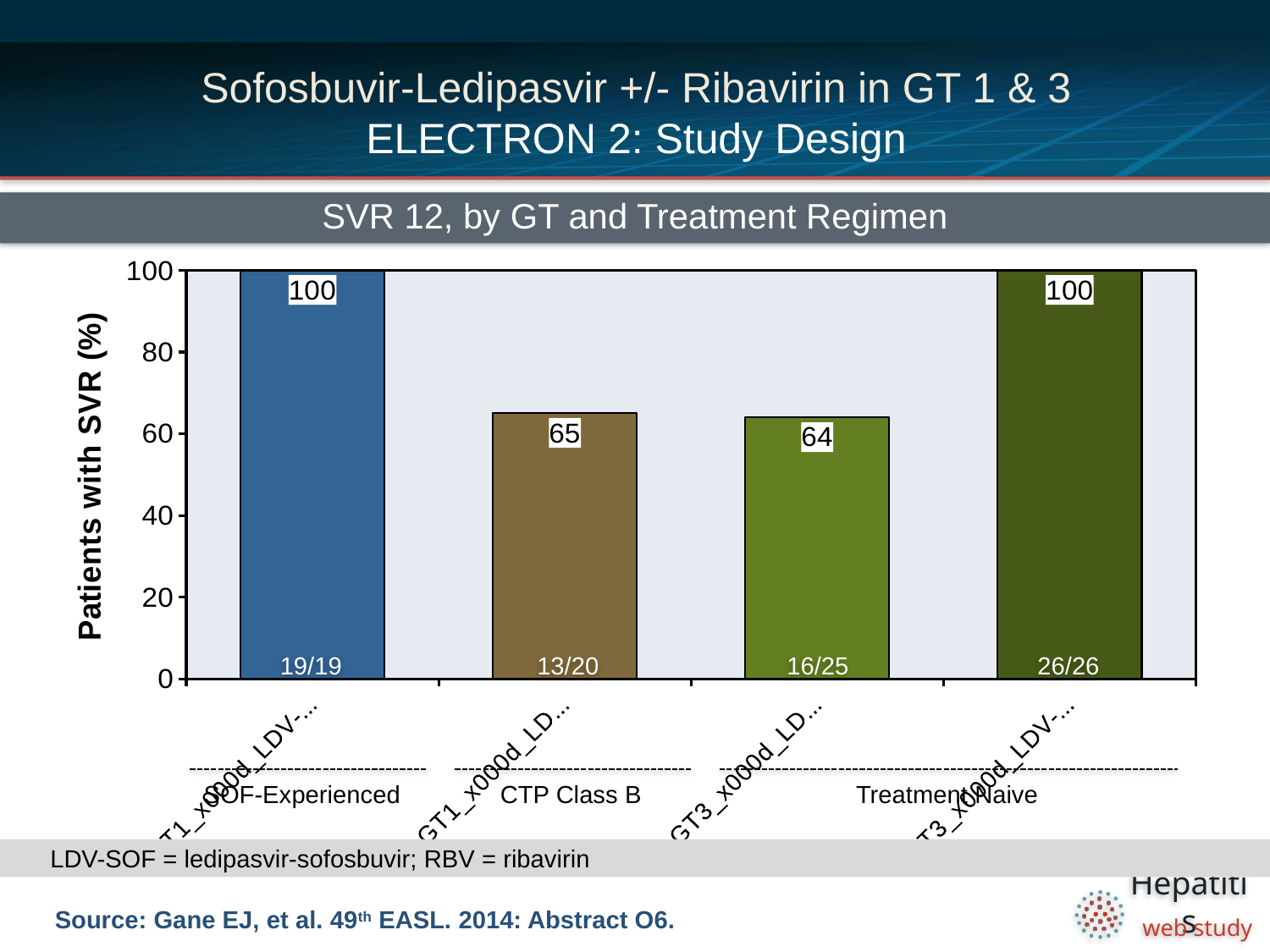
What is the difference between the SVR value of the first bar (19/19) and the second bar (13/20)? 35 What is the title of the chart? SVR 12, by GT and Treatment Regimen What is the SVR value shown on the third bar, labeled 16/25? 64 What is the SVR value shown on the second bar, labeled 13/20? 65 What is the label of the y-axis? Patients with SVR (%) What kind of chart is shown on the slide? bar chart What is the SVR value shown on the fourth (rightmost) bar, labeled 26/26? 100 How many bars are plotted in the chart? 4 What is the difference between the SVR value of the fourth bar (26/26) and the third bar (16/25)? 36 What is the SVR value shown on the first (leftmost) bar? 100 Is the SVR value of the second bar (13/20) greater or less than the first bar (19/19)? less Is the SVR value of the third bar (16/25) greater or less than 80? less